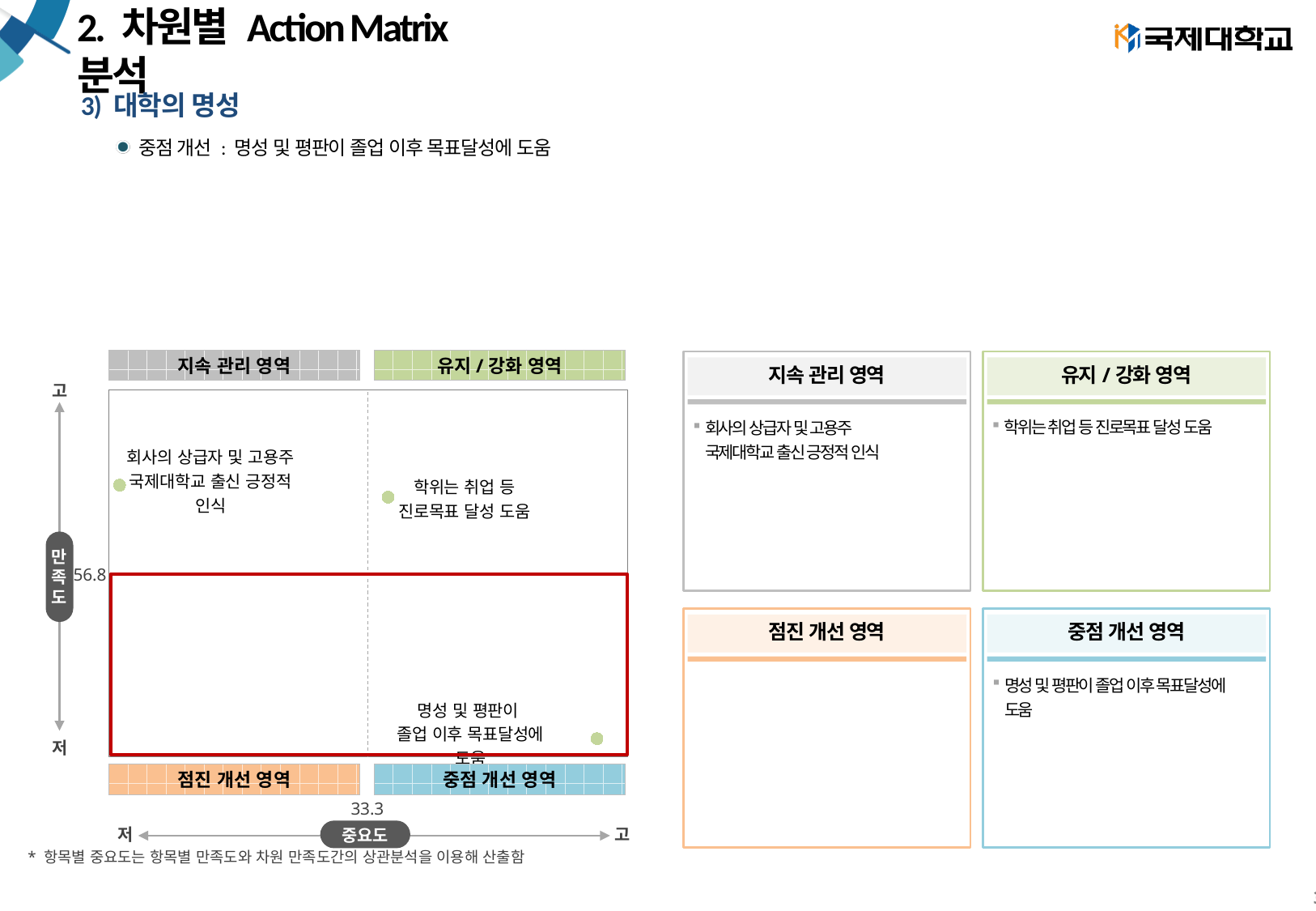
In the action matrix chart, is the satisfaction value for '명성 및 평판이 졸업 이후 목표달성에 도움' greater or less than 56.8? less How many data points are plotted in the action matrix chart? 3 In the action matrix chart, which point has the lowest satisfaction (만족도)? 명성 및 평판이 졸업 이후 목표달성에 도움 In the action matrix chart, is the importance value for '회사의 상급자 및 고용주 국제대학교 출신 긍정적 인식' greater or less than 33.3? less In the action matrix chart, which point has the lowest importance (중요도)? 회사의 상급자 및 고용주 국제대학교 출신 긍정적 인식 In the action matrix chart, is the satisfaction value for '학위는 취업 등 진로목표 달성 도움' greater or less than 56.8? greater What is the satisfaction (만족도) reference value marked on the vertical axis of the action matrix chart? 56.8 What kind of chart is shown on the left of the slide? scatter chart In the action matrix chart, which point has the highest importance (중요도)? 명성 및 평판이 졸업 이후 목표달성에 도움 In the action matrix chart, which quadrant does '학위는 취업 등 진로목표 달성 도움' fall in? 유지 / 강화 영역 In the action matrix chart, which point has higher satisfaction: '학위는 취업 등 진로목표 달성 도움' or '명성 및 평판이 졸업 이후 목표달성에 도움'? 학위는 취업 등 진로목표 달성 도움 What is the importance (중요도) reference value marked on the horizontal axis of the action matrix chart? 33.3